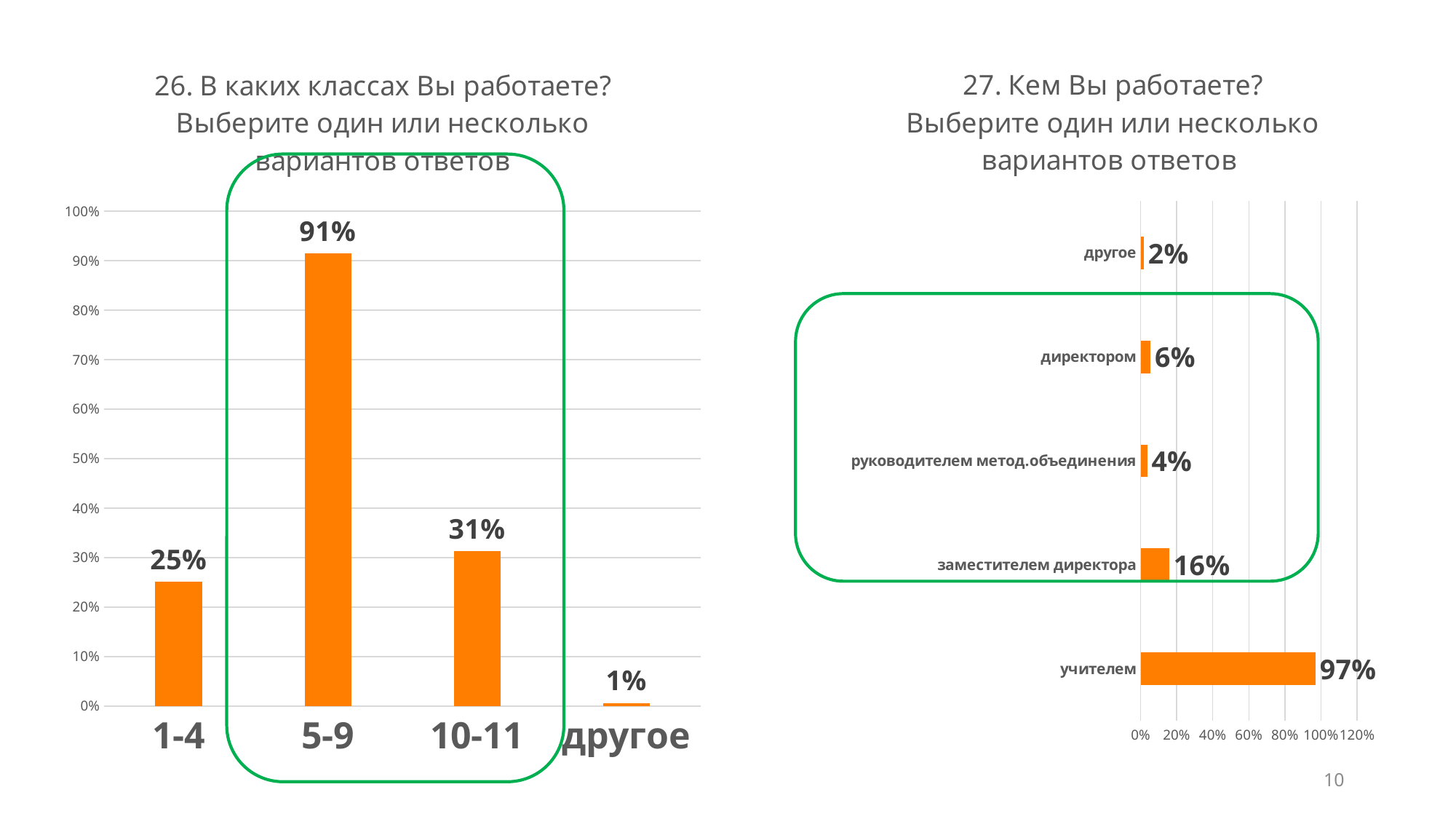
In the left chart (question 26), what is the value for the category '1-4'? 25% In the left chart (question 26, 'В каких классах Вы работаете?'), what is the value for the category '5-9'? 91% In the left chart (question 26), how many categories are shown on the x axis? 4 In the left chart (question 26), what kind of chart is it? Bar chart In the left chart (question 26), which category has the lowest value? другое In the right chart (question 27), which category has the lowest value? другое In the right chart (question 27), what is the value for 'заместителем директора'? 16% In the right chart (question 27), how many categories are shown? 5 In the left chart (question 26), which category has the highest value? 5-9 In the right chart (question 27), which is larger: the value for 'директором' or the value for 'руководителем метод.объединения'? директором In the left chart (question 26), what is the difference between the values for '5-9' and '10-11'? 60% In the right chart (question 27, 'Кем Вы работаете?'), what is the value for 'учителем'? 97%